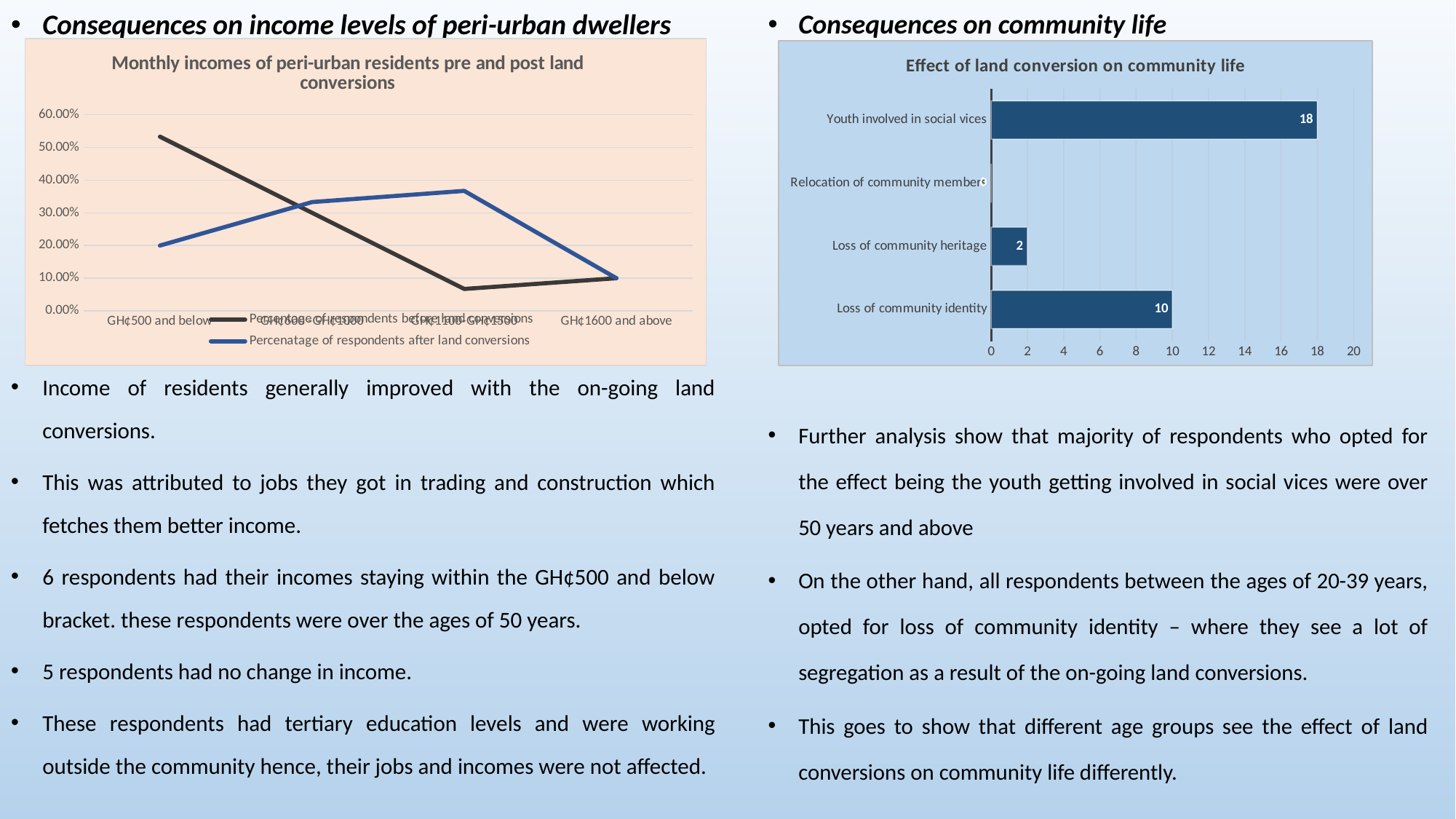
In the 'Effect of land conversion on community life' chart, what is the value for Loss of community identity? 10 In the 'Effect of land conversion on community life' chart, which is larger: Loss of community identity or Loss of community heritage? Loss of community identity In the 'Monthly incomes of peri-urban residents pre and post land conversions' chart, does the 'Percentage of respondents before land conversions' line rise or fall from GH₵500 and below to GH₵1600 and above? Fall In the 'Effect of land conversion on community life' chart, which category has the highest value? Youth involved in social vices What kind of chart is the 'Monthly incomes of peri-urban residents pre and post land conversions' chart? Line chart How many categories are shown in the 'Effect of land conversion on community life' chart? 4 In the 'Effect of land conversion on community life' chart, what is the value for Youth involved in social vices? 18 How many series does the legend of the 'Monthly incomes of peri-urban residents pre and post land conversions' chart list? 2 In the 'Monthly incomes of peri-urban residents pre and post land conversions' chart, is the value for 'Percentage of respondents before land conversions' at GH₵500 and below greater or less than 40.00%? greater In the 'Effect of land conversion on community life' chart, what is the difference between Youth involved in social vices and Loss of community identity? 8 What kind of chart is the 'Effect of land conversion on community life' chart? Bar chart In the 'Effect of land conversion on community life' chart, what is the value for Loss of community heritage? 2